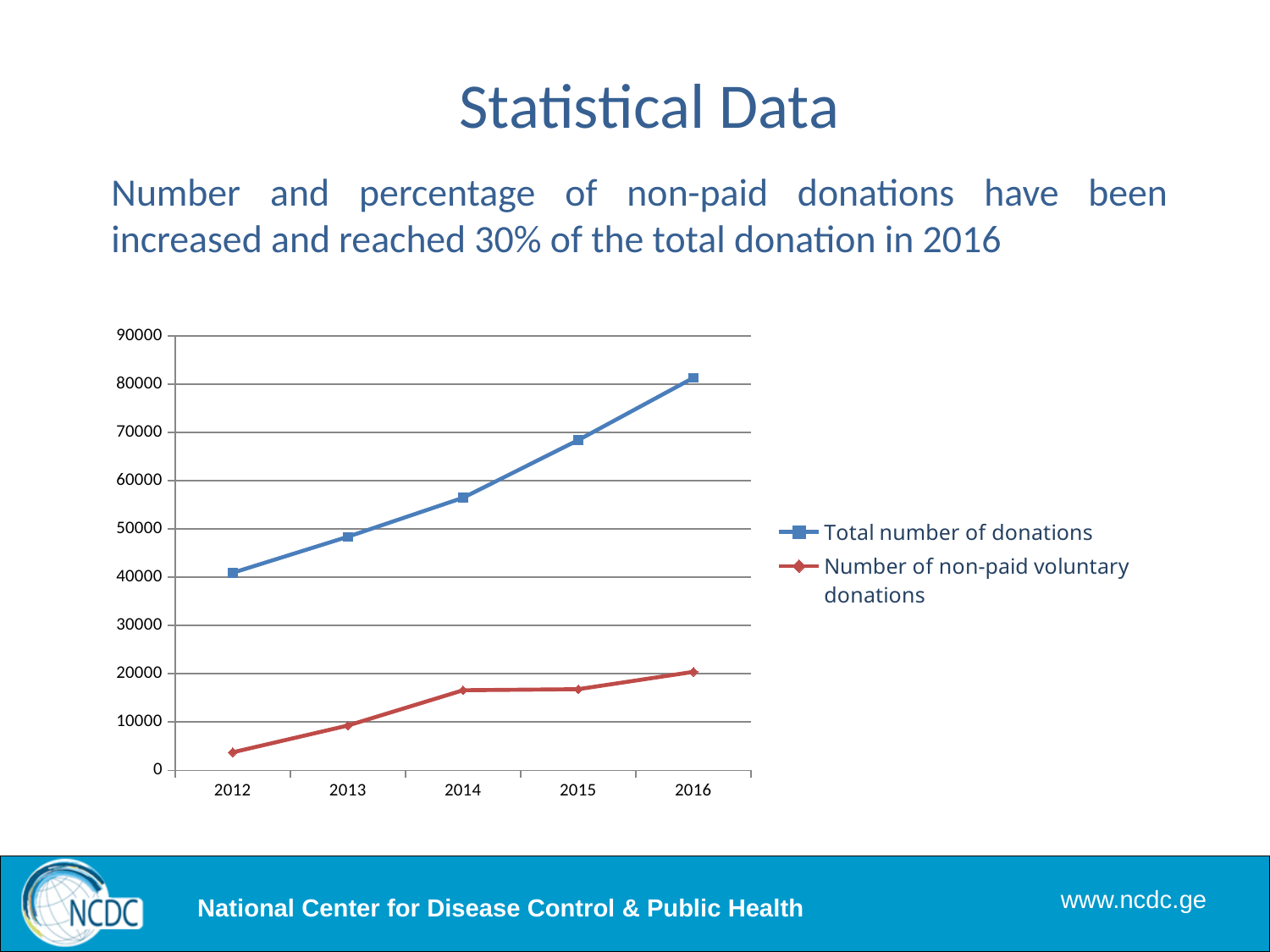
Is the Number of non-paid voluntary donations in 2016 greater or less than 10000? greater How many series does the legend list? 2 Is the Total number of donations in 2016 greater or less than 70000? greater Is the Total number of donations in 2012 greater or less than 50000? less How many years are plotted on the x axis? 5 Which series is shown with the red line? Number of non-paid voluntary donations Does the Total number of donations rise or fall from 2012 to 2016? rise In which year is the Total number of donations highest? 2016 What kind of chart is shown on the slide? line chart In which year is the Number of non-paid voluntary donations lowest? 2012